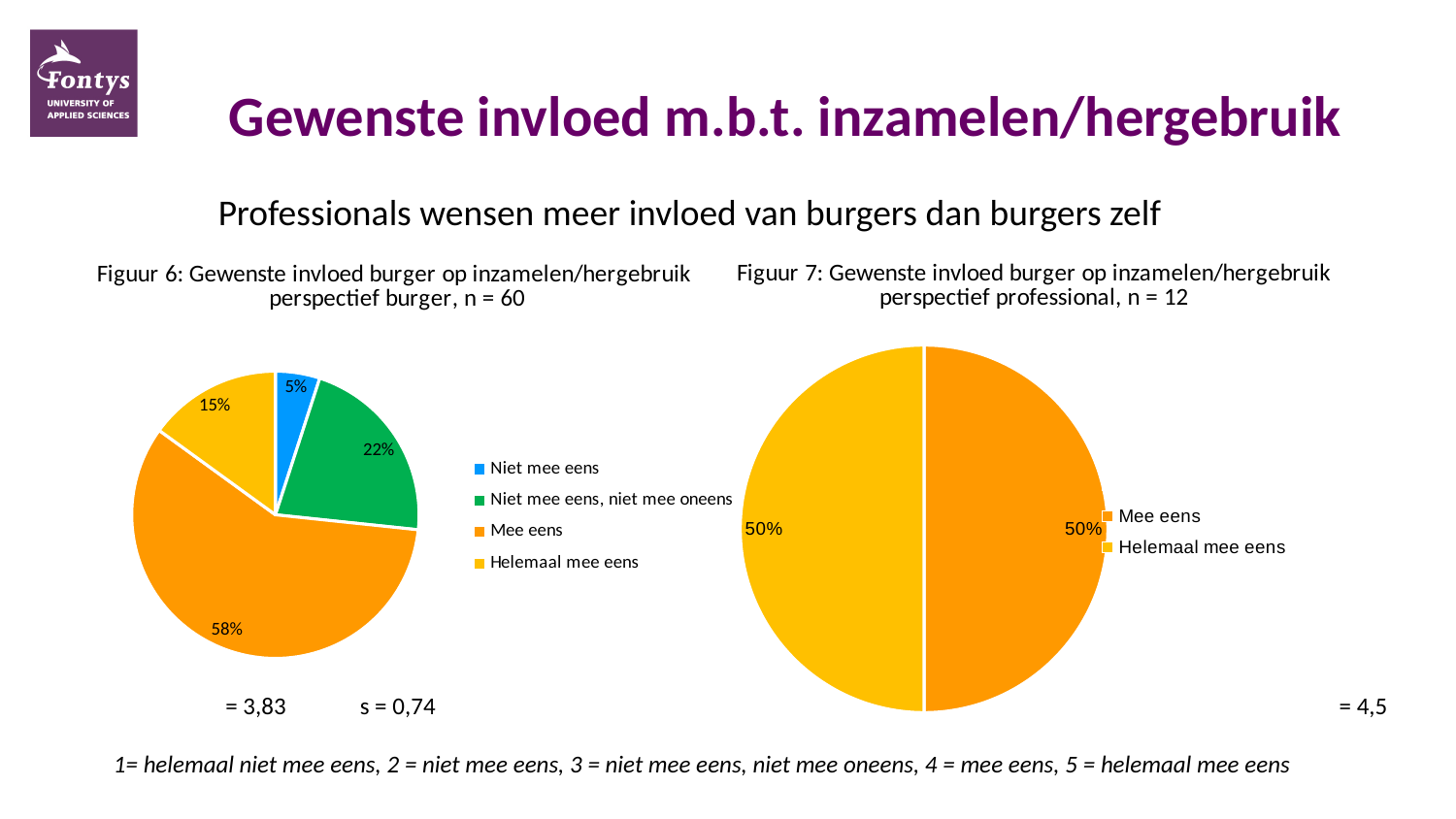
In Figuur 6 (perspectief burger), which is larger: "Niet mee eens, niet mee oneens" or "Helemaal mee eens"? Niet mee eens, niet mee oneens How many categories does the legend of Figuur 6 (perspectief burger) list? 4 In Figuur 6 (perspectief burger), which category has the largest share? Mee eens How many categories does the legend of Figuur 7 (perspectief professional) list? 2 In Figuur 6 (perspectief burger), what is the difference in percentage points between "Mee eens" and "Helemaal mee eens"? 43 In Figuur 7 (perspectief professional), what percentage of respondents answered "Helemaal mee eens"? 50% In Figuur 6 (perspectief burger), what percentage of respondents answered "Helemaal mee eens"? 15% In Figuur 6 (perspectief burger), what percentage of respondents answered "Mee eens"? 58% In Figuur 6 (perspectief burger), which category has the smallest share? Niet mee eens In Figuur 6 (perspectief burger), what percentage of respondents answered "Niet mee eens"? 5% In Figuur 6 (perspectief burger), what percentage of respondents answered "Niet mee eens, niet mee oneens"? 22% What type of chart is Figuur 7 (perspectief professional)? Pie chart